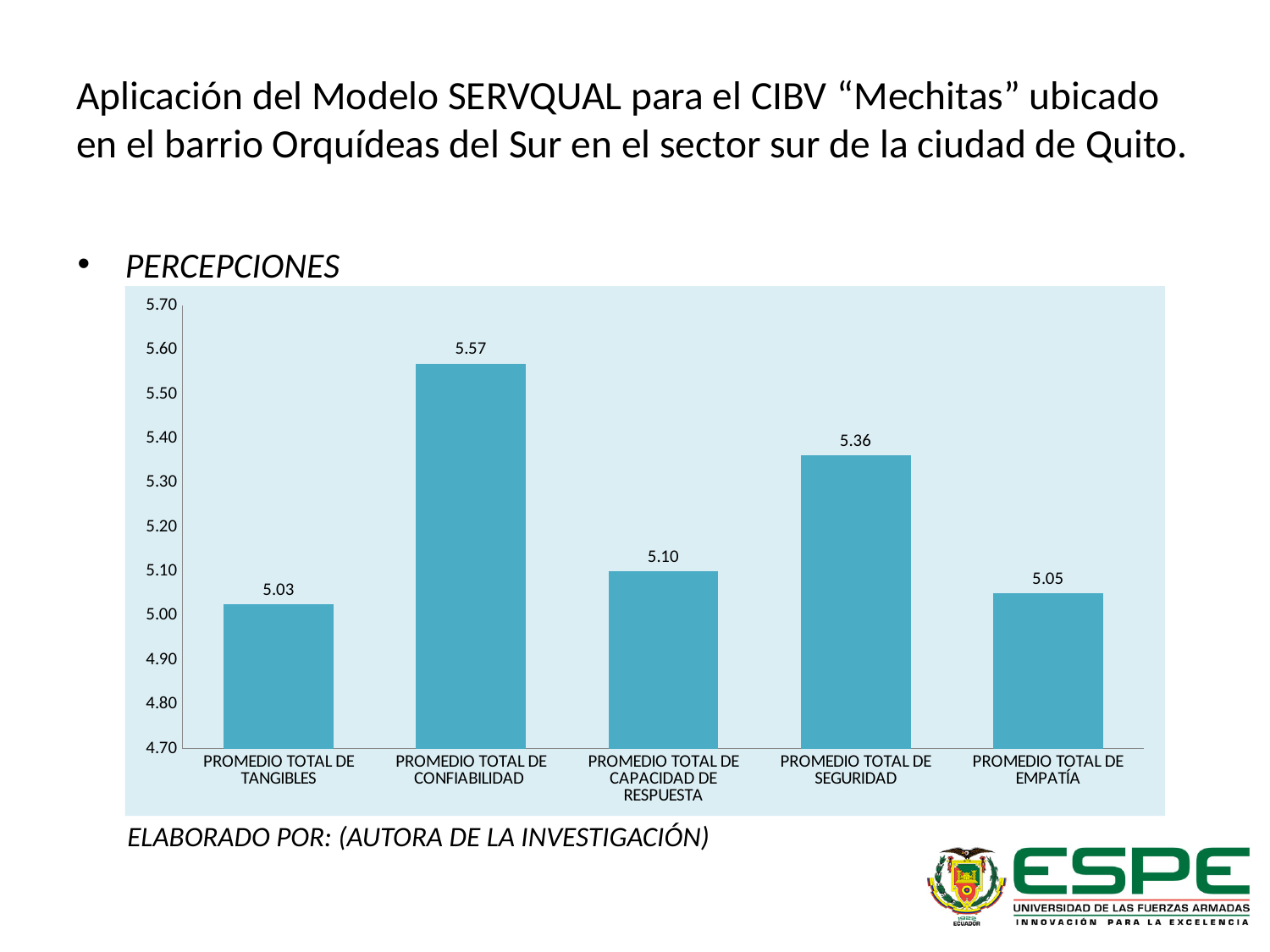
Which category has the highest value? PROMEDIO TOTAL DE CONFIABILIDAD Which category has the lowest value? PROMEDIO TOTAL DE TANGIBLES What is the value for PROMEDIO TOTAL DE SEGURIDAD? 5.36 What is the value for PROMEDIO TOTAL DE EMPATÍA? 5.05 What is the value for PROMEDIO TOTAL DE TANGIBLES? 5.03 How many categories are shown in the chart? 5 What is the value for PROMEDIO TOTAL DE CONFIABILIDAD? 5.57 Which is larger, the value for PROMEDIO TOTAL DE SEGURIDAD or PROMEDIO TOTAL DE CAPACIDAD DE RESPUESTA? PROMEDIO TOTAL DE SEGURIDAD What is the value for PROMEDIO TOTAL DE CAPACIDAD DE RESPUESTA? 5.10 What kind of chart is shown on the slide? bar chart Is the value for PROMEDIO TOTAL DE CONFIABILIDAD greater or less than 5.50? greater What is the difference between the values for PROMEDIO TOTAL DE CONFIABILIDAD and PROMEDIO TOTAL DE SEGURIDAD? 0.21